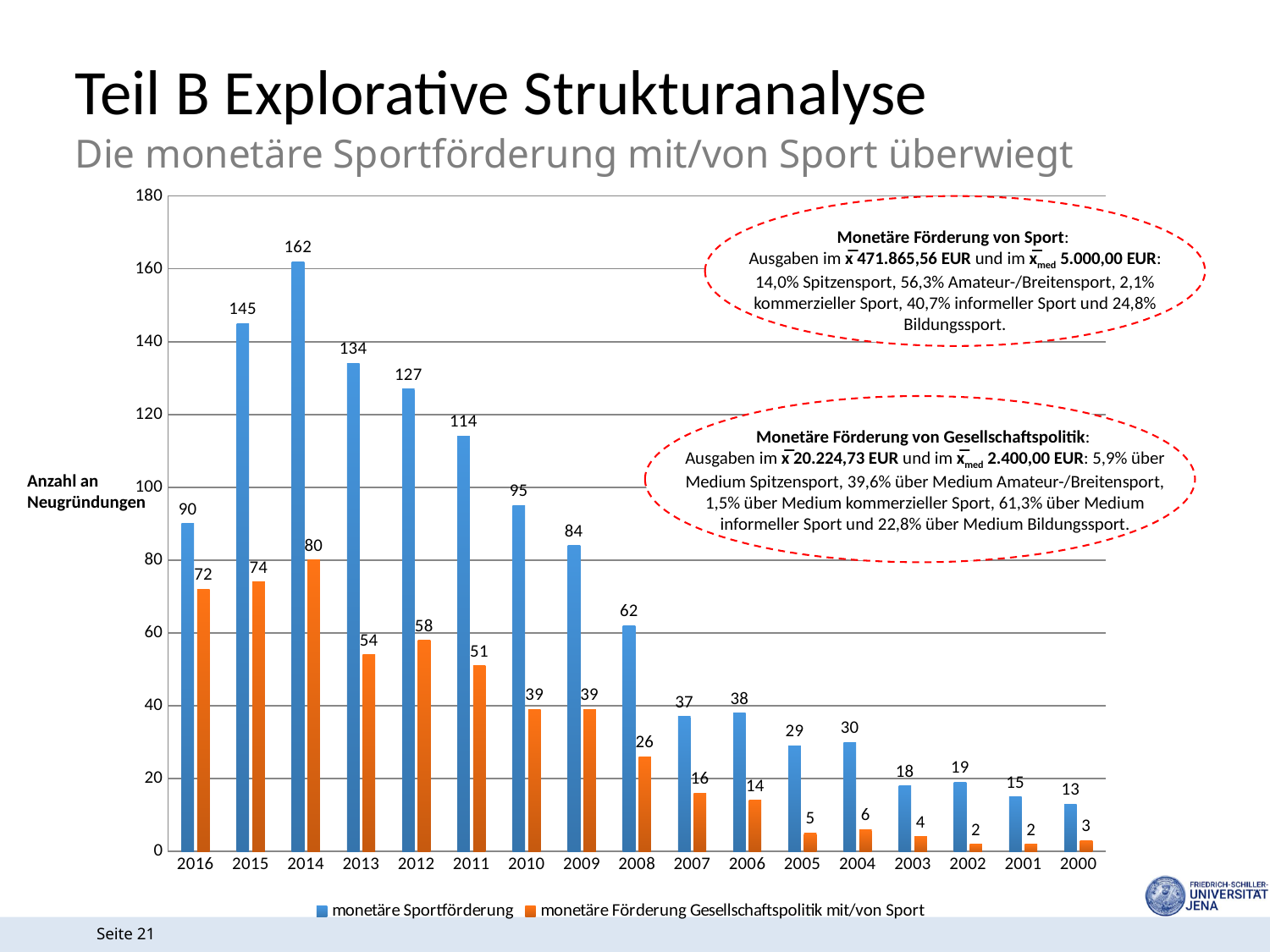
Is the value for monetäre Sportförderung in 2013 greater or less than 120? greater What is the label of the y axis? Anzahl an Neugründungen Which is larger in 2008: monetäre Sportförderung or monetäre Förderung Gesellschaftspolitik mit/von Sport? monetäre Sportförderung What is the value for monetäre Sportförderung in 2014? 162 What is the value for monetäre Förderung Gesellschaftspolitik mit/von Sport in 2012? 58 In which year is monetäre Sportförderung highest? 2014 How many years are shown on the x axis? 17 What colour are the bars for monetäre Förderung Gesellschaftspolitik mit/von Sport? orange In which year is monetäre Förderung Gesellschaftspolitik mit/von Sport lowest? 2002 and 2001 What kind of chart is shown on the slide? bar chart What is the difference between monetäre Sportförderung and monetäre Förderung Gesellschaftspolitik mit/von Sport in 2015? 71 How many series does the legend list? 2